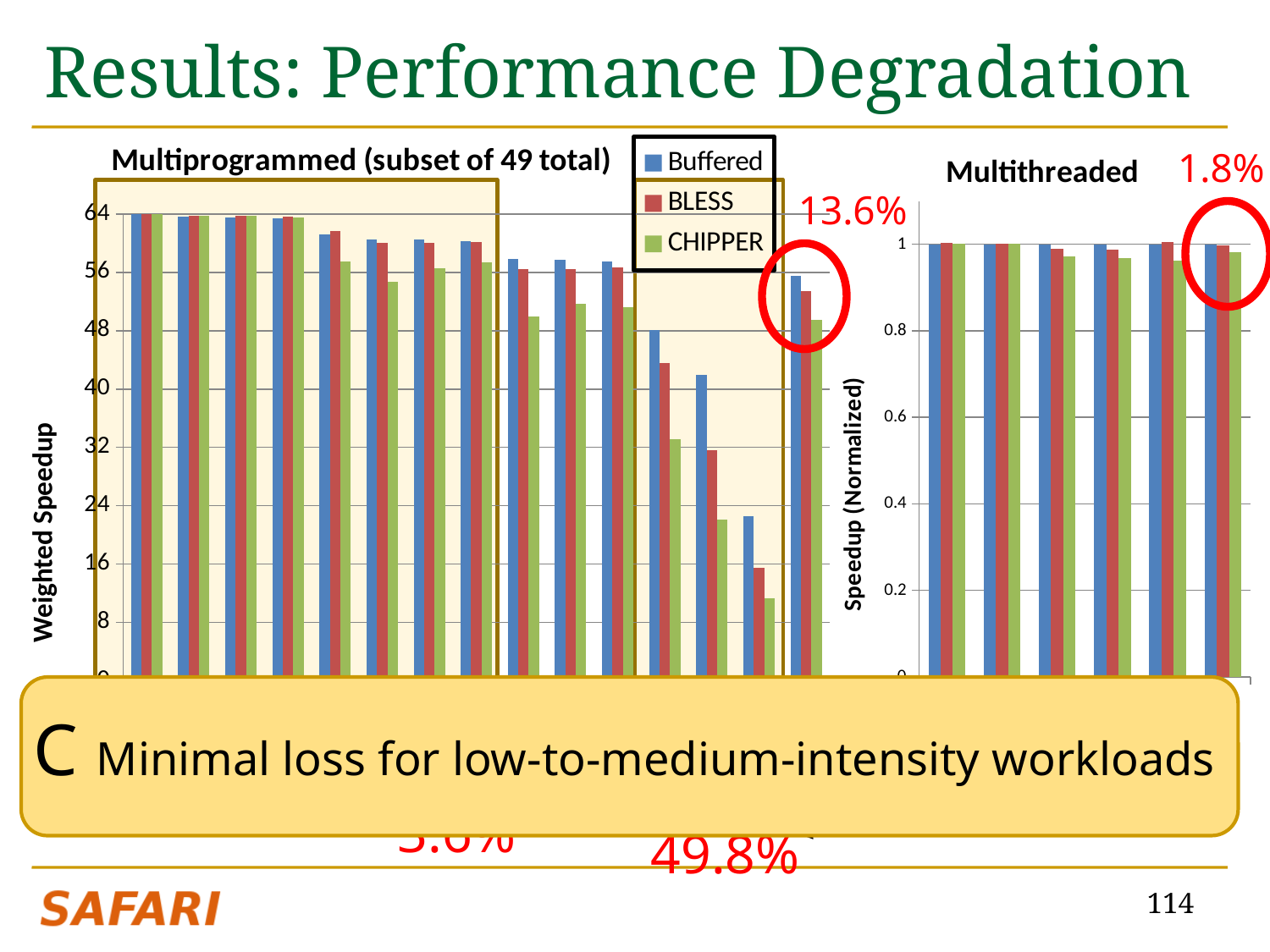
How many series does the legend list for the charts on this slide? 3 How many groups of bars are plotted in the Multithreaded chart? 6 What kind of chart is the Multiprogrammed (subset of 49 total) chart? bar chart What is the y-axis title of the Multiprogrammed (subset of 49 total) chart? Weighted Speedup In the Multiprogrammed (subset of 49 total) chart, is the CHIPPER value for the rightmost fully visible group (second from the right) greater or less than 16? less In the Multithreaded chart, are all CHIPPER bars greater or less than 0.6? greater In the Multiprogrammed (subset of 49 total) chart, is the Buffered value for the leftmost group greater or less than 56? greater Which series are listed in the legend? Buffered, BLESS, CHIPPER What kind of chart is the Multithreaded chart? bar chart